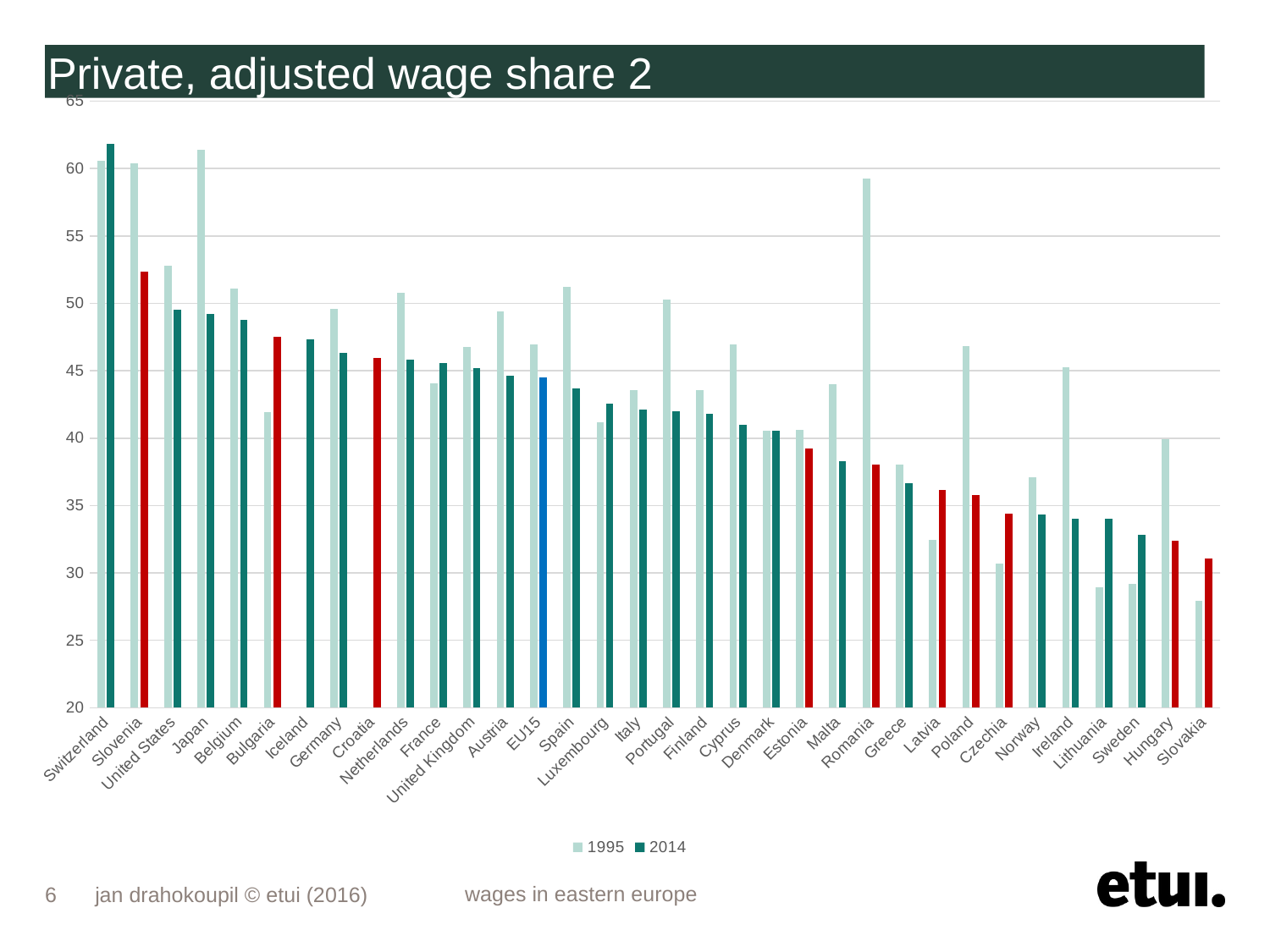
How many countries or regions are shown on the x axis? 34 Which country has the lowest 2014 value? Slovakia How many series does the legend list? 2 Is the 1995 value for Czechia greater or less than 35? less Is the 2014 value for Slovenia greater or less than 50? greater Is the 1995 value for Japan greater or less than 60? greater Which is larger for Romania, the 1995 value or the 2014 value? 1995 What is the title of the chart? Private, adjusted wage share 2 Do the 2014 values generally rise or fall moving from left to right along the x axis? fall Which country has the highest 2014 value? Switzerland What kind of chart is shown on the slide? bar chart